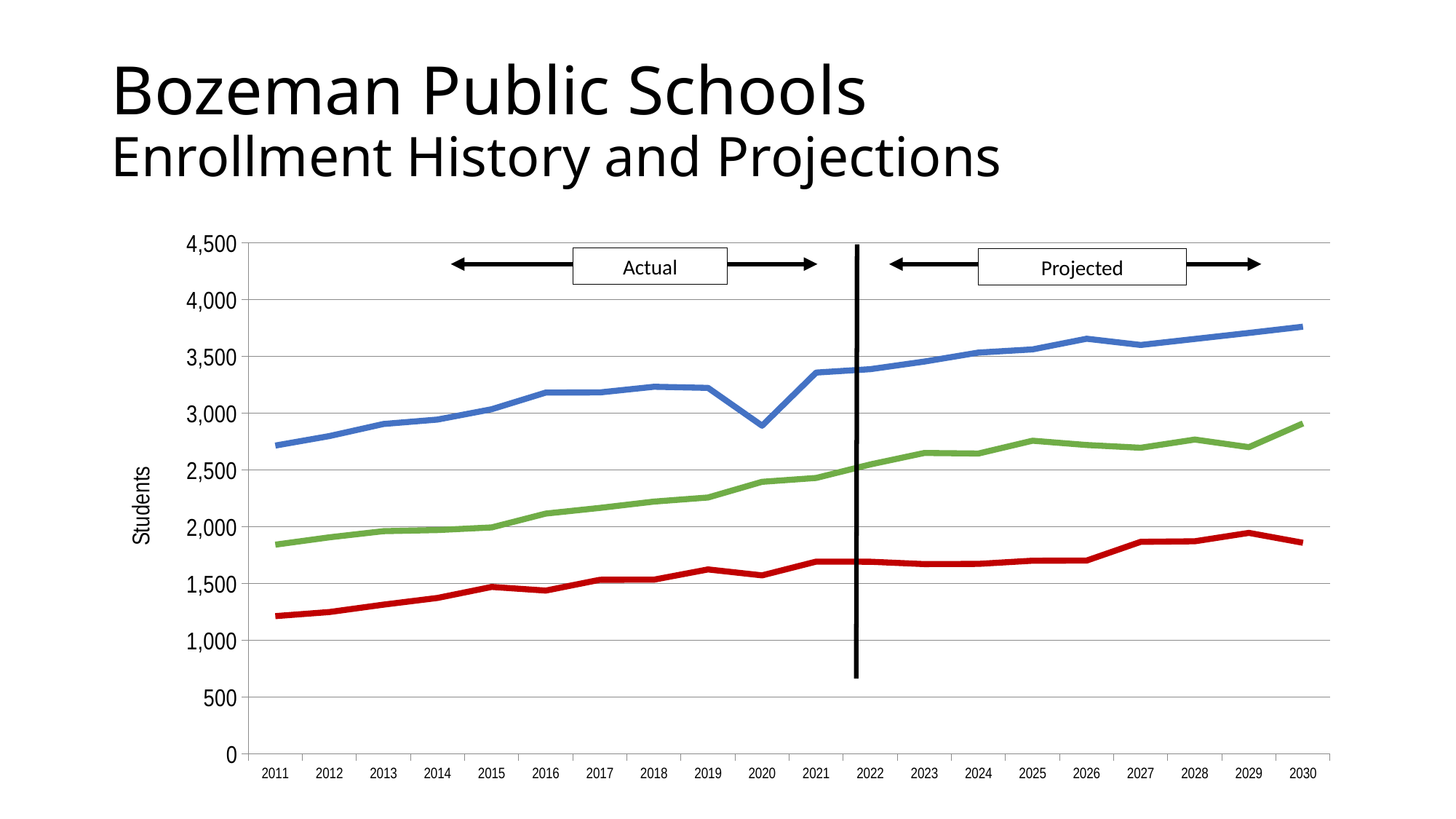
What are the two labels in the boxes above the lines that divide the chart into periods? Actual and Projected In which year does the blue line reach its highest value? 2030 In 2030, which line has the higher value, the blue line or the green line? Blue line Is the value of the blue line in 2020 greater or less than 3,000? less Does the green line generally rise or fall from 2011 to 2030? Rise How many years are shown along the x axis of the chart? 20 Is the value of the blue line in 2030 greater or less than 3,500? greater What is the label on the vertical axis of the chart? Students Is the value of the blue line in 2011 greater or less than 2,500? greater What kind of chart is shown on the slide? Line chart